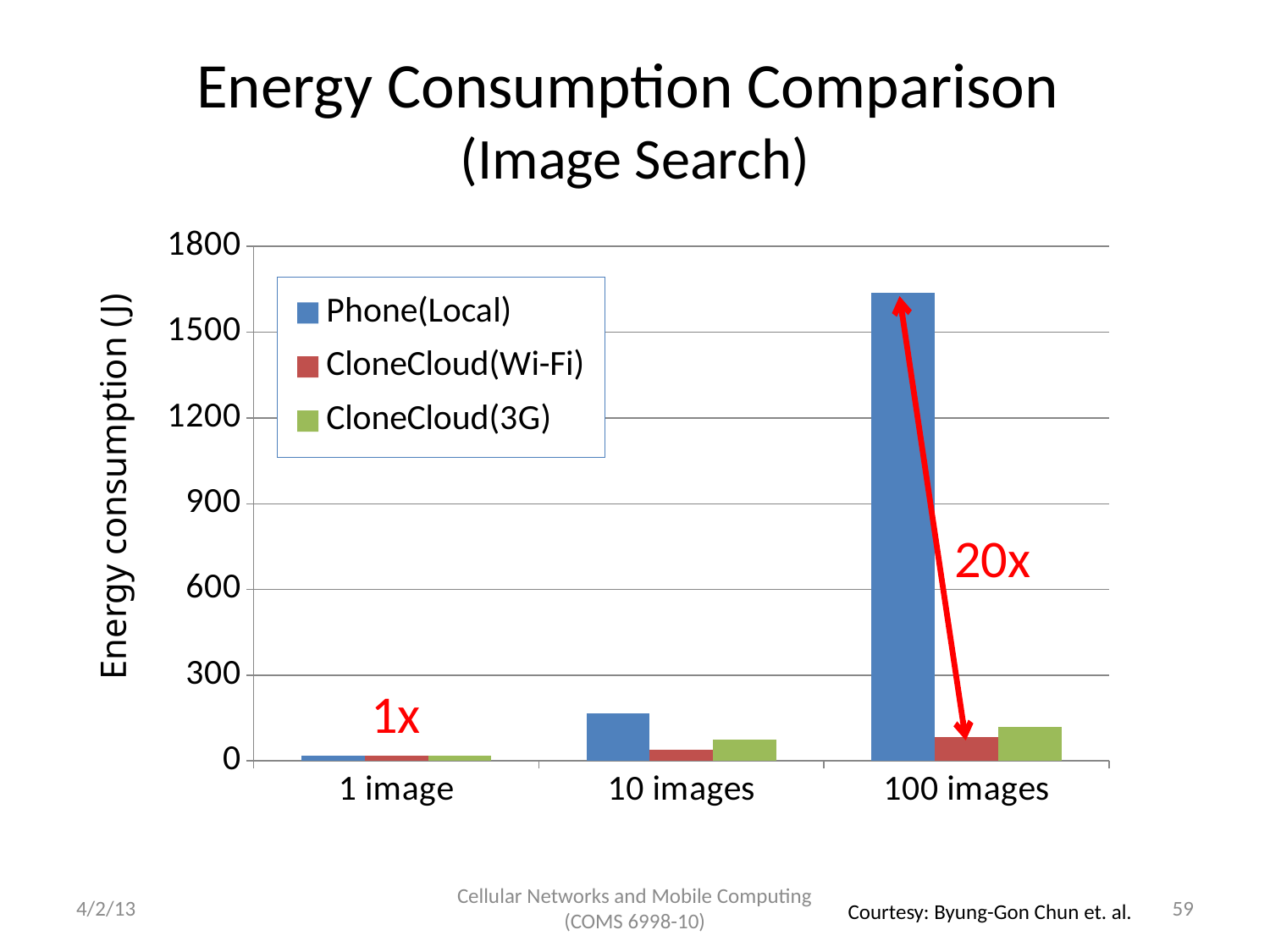
How many categories are shown on the x axis? 3 How many series does the legend list? 3 For which category is the Phone(Local) energy consumption highest? 100 images What kind of chart is shown on the slide? bar chart Does the Phone(Local) energy consumption rise or fall from 1 image to 100 images? rise Which series has the highest energy consumption for 100 images? Phone(Local) For 10 images, which is larger: CloneCloud(Wi-Fi) or CloneCloud(3G)? CloneCloud(3G) Is the Phone(Local) value for 10 images greater or less than 300? less What is the label of the y axis? Energy consumption (J) Is the CloneCloud(3G) value for 100 images greater or less than 300? less Is the Phone(Local) value for 100 images greater or less than 1500? greater Which series has the lowest energy consumption for 100 images? CloneCloud(Wi-Fi)